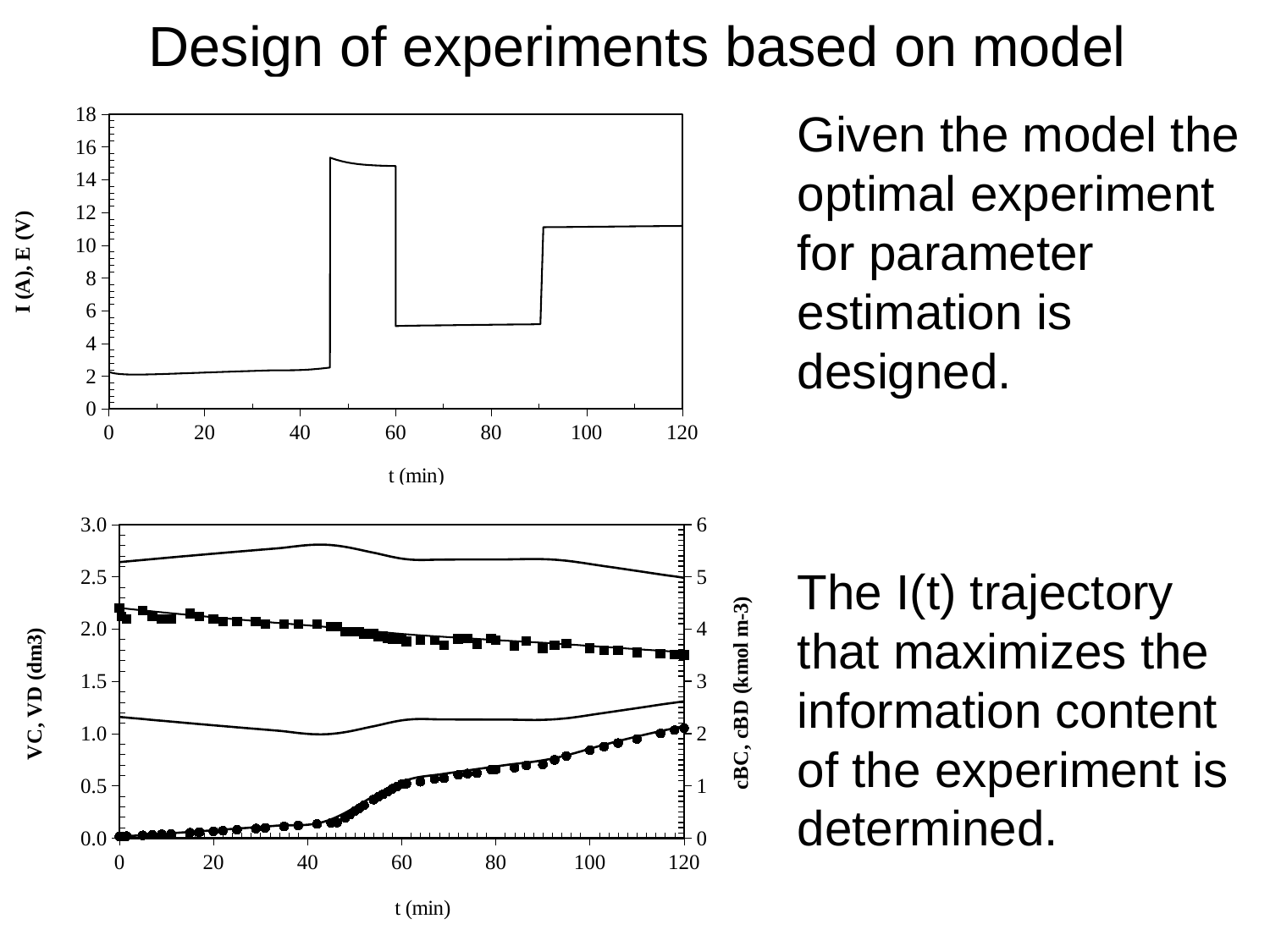
In the top chart, is the value at t = 50 min greater or less than 14? greater In the top chart, is the value at t = 100 min greater or less than 10? greater In the bottom chart, does the series plotted with square markers rise or fall as t increases? fall What is the highest tick value shown on the x-axis of the bottom chart? 120 What kind of chart is the top chart on the slide? line chart What is the y-axis label of the top chart? I (A), E (V) In the top chart, is the value at t = 50 min larger or smaller than the value at t = 100 min? larger In the bottom chart, does the series plotted with circle markers rise or fall as t increases? rise In the top chart, is the value at t = 70 min greater or less than 6? less What is the highest tick value shown on the right-hand y-axis of the bottom chart? 6 What is the x-axis label of the top chart? t (min)